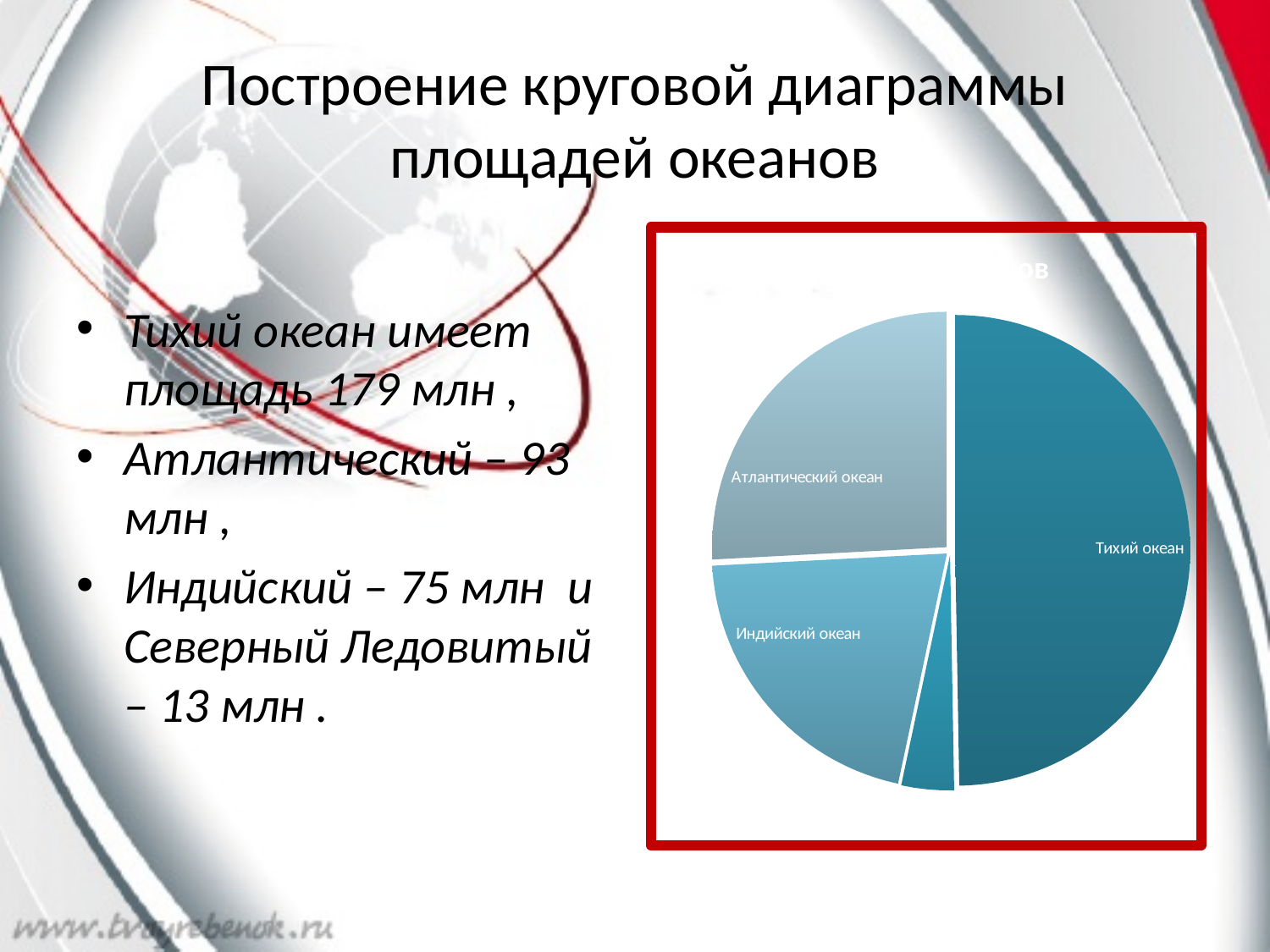
Which ocean has the largest slice in the pie chart? Тихий океан Which labelled slice of the pie chart is the smallest? Индийский океан How many slices does the pie chart have? 4 Which slice of the pie chart is in the upper-left part of the pie? Атлантический океан Which slice of the pie chart is positioned on the right half of the pie? Тихий океан Which slice is larger in the pie chart, Тихий океан or Индийский океан? Тихий океан What kind of chart is shown on the slide? pie chart How many slices of the pie chart have a readable label? 3 Which slice is larger in the pie chart, Тихий океан or Атлантический океан? Тихий океан Which slice is larger in the pie chart, Атлантический океан or Индийский океан? Атлантический океан